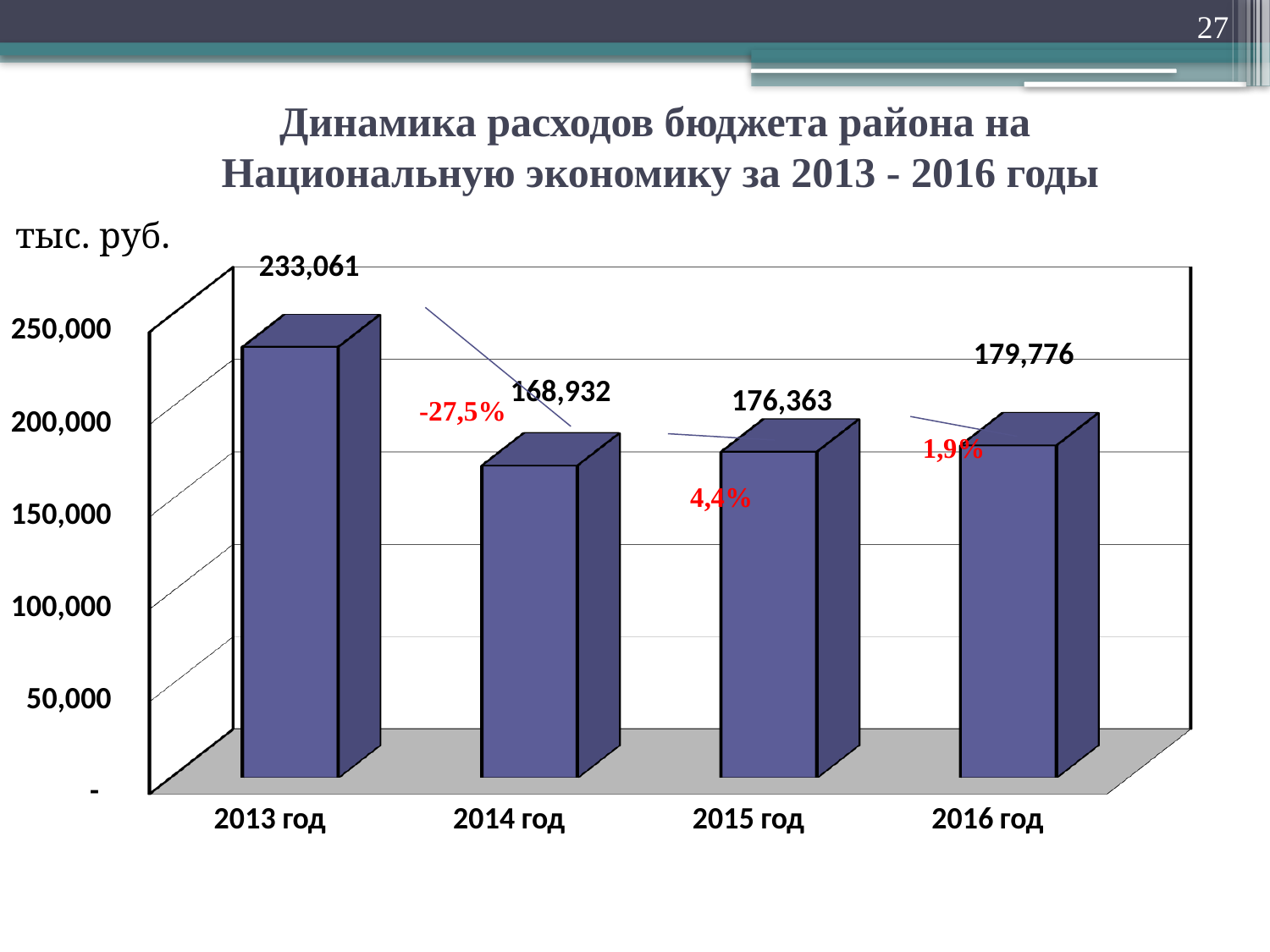
Is the value for 2014 год greater or less than 200,000? less Which is larger, the value for 2015 год or the value for 2016 год? 2016 год What is the difference between the values for 2013 год and 2014 год? 64,129 What is the value for 2013 год? 233,061 What kind of chart is shown on the slide? bar chart Which year has the highest value? 2013 год What is the value for 2014 год? 168,932 Which year has the lowest value? 2014 год What is the value for 2016 год? 179,776 What is the difference between the values for 2015 год and 2014 год? 7,431 How many years are shown on the x axis? 4 What percentage change is labelled between 2013 год and 2014 год? -27,5%